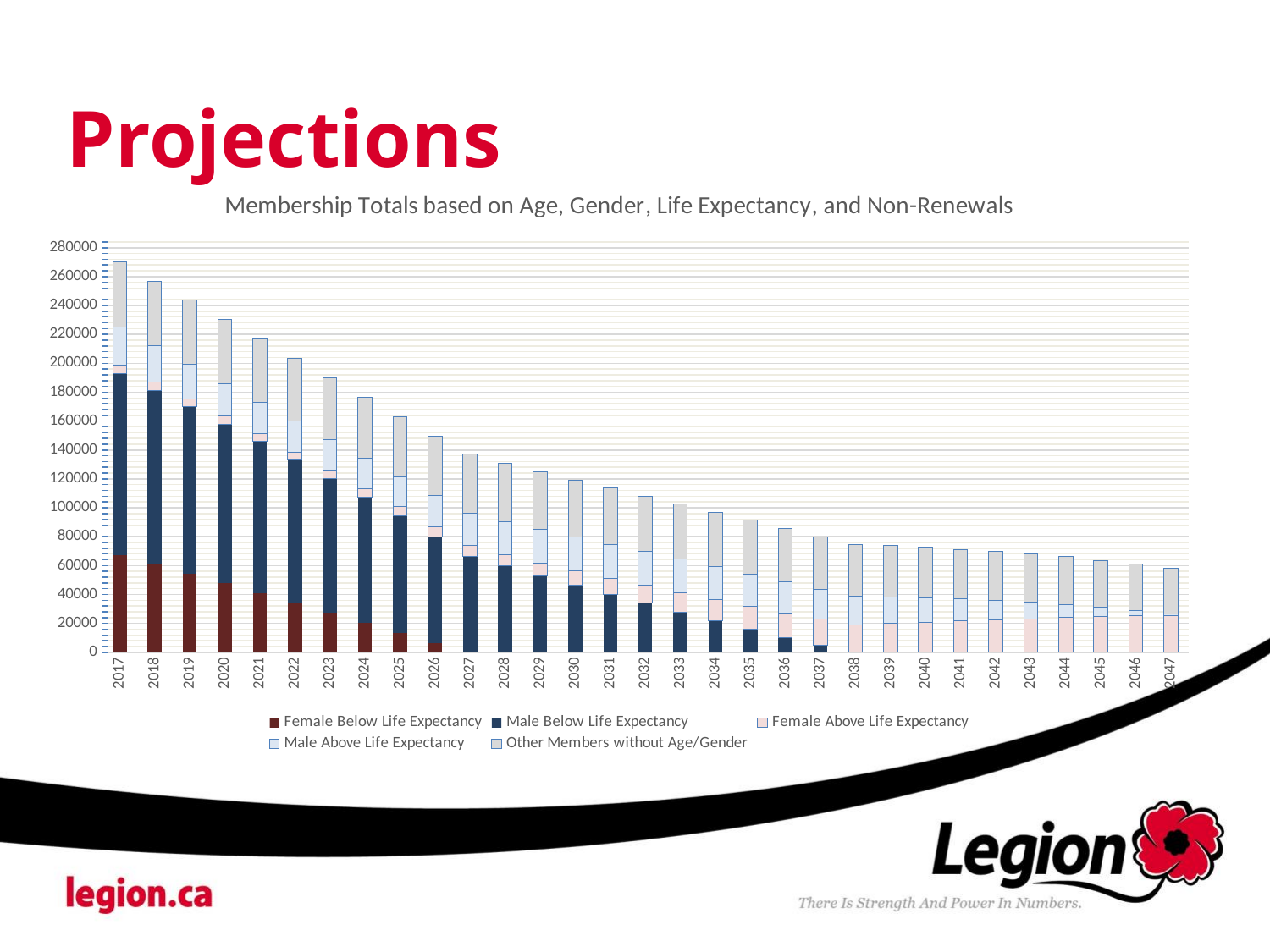
Is the total membership for 2030 greater or less than 100000? greater How many years are shown along the x axis? 31 Which year has the lowest total membership? 2047 Which legend entry is shown in dark red? Female Below Life Expectancy Do the total membership values rise or fall from 2017 to 2047? Fall What is the title of the chart? Membership Totals based on Age, Gender, Life Expectancy, and Non-Renewals How many series does the legend list? 5 Which year has the highest total membership? 2017 What kind of chart is shown on the slide? Stacked bar chart Is the total membership for 2017 greater or less than 260000? greater Is the total membership for 2047 greater or less than 80000? less Which year has the larger total membership, 2020 or 2030? 2020